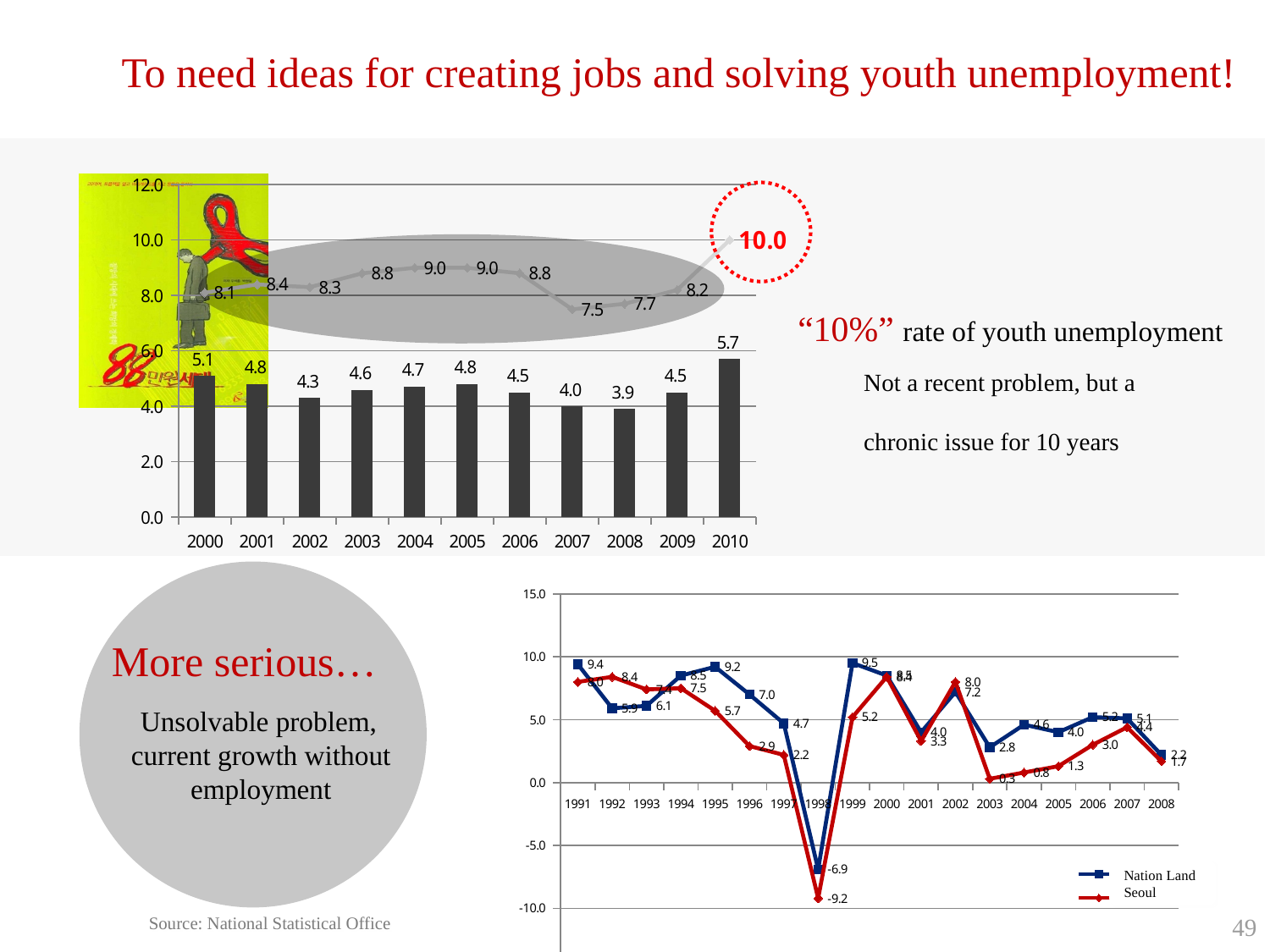
In the top chart, which year has the lowest bar value? 2008 In the top chart, what is the value of the line series for 2010? 10.0 In the bottom chart, which year has the lowest Seoul value? 1998 In the bottom chart, how many series does the legend list? 2 In the top chart, what is the value of the bar for 2010? 5.7 In the top chart, which is larger, the line value for 2004 or the line value for 2007? 2004 In the bottom chart, what is the difference between the Nation Land and Seoul values for 2003? 2.5 In the top chart, how many years are shown on the x axis? 11 In the bottom chart, what is the Seoul value for 1998? -9.2 In the top chart, what is the difference between the bar values for 2010 and 2008? 1.8 What type of chart is the bottom chart? Line chart In the bottom chart, what is the Nation Land value for 1998? -6.9